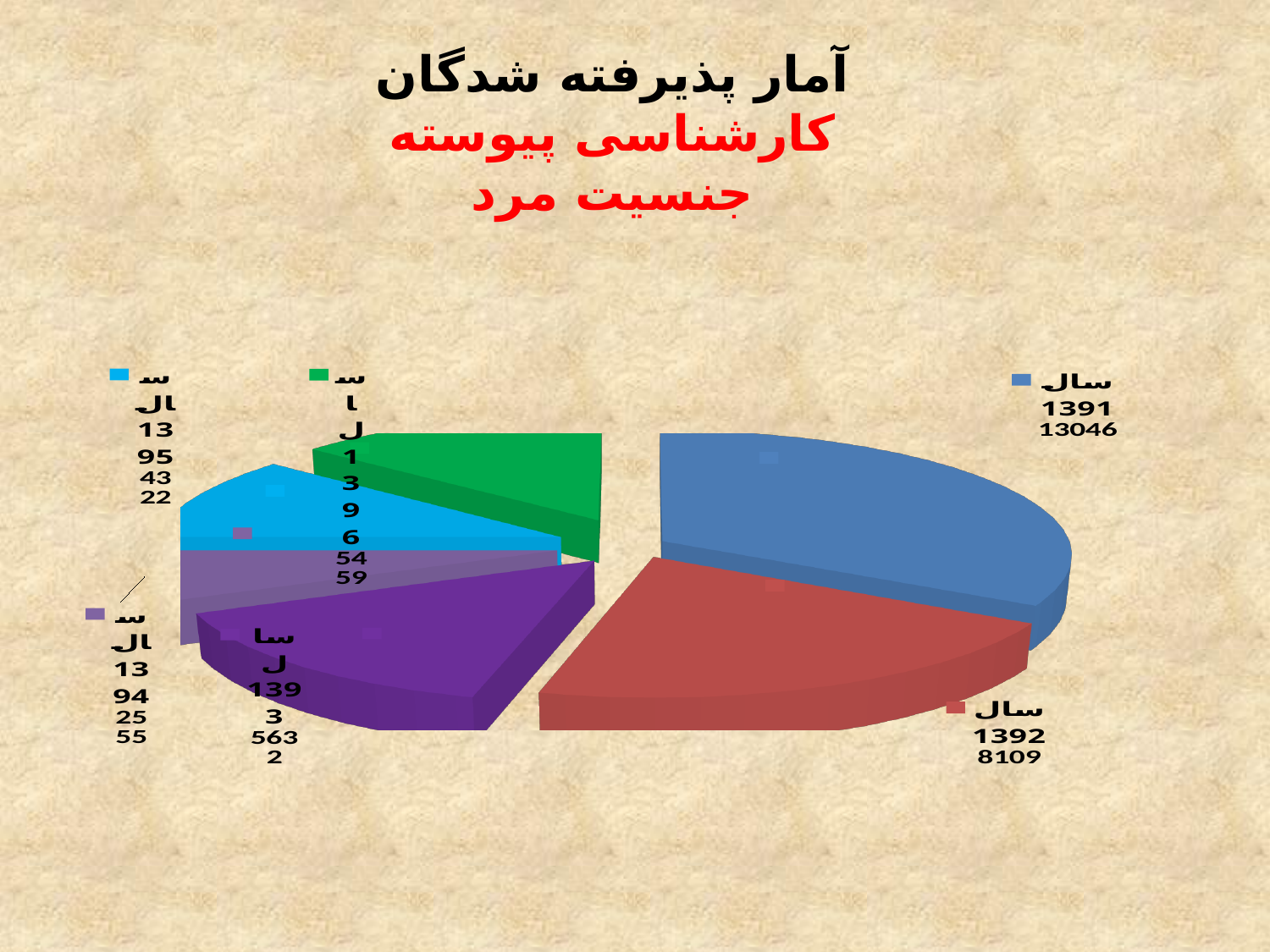
What is the value for سال 1393? 5632 Which colour is the slice for سال 1392? red What kind of chart is shown on the slide? pie chart What is the value for سال 1396? 5459 Which year has the smallest slice of the pie? سال 1394 What is the value for سال 1391? 13046 What is the difference between the values for سال 1391 and سال 1392? 4937 What is the value for سال 1394? 2555 Which year has the largest slice of the pie? سال 1391 How many slices does the pie chart have? 6 What is the value for سال 1392? 8109 What is the value for سال 1395? 4322